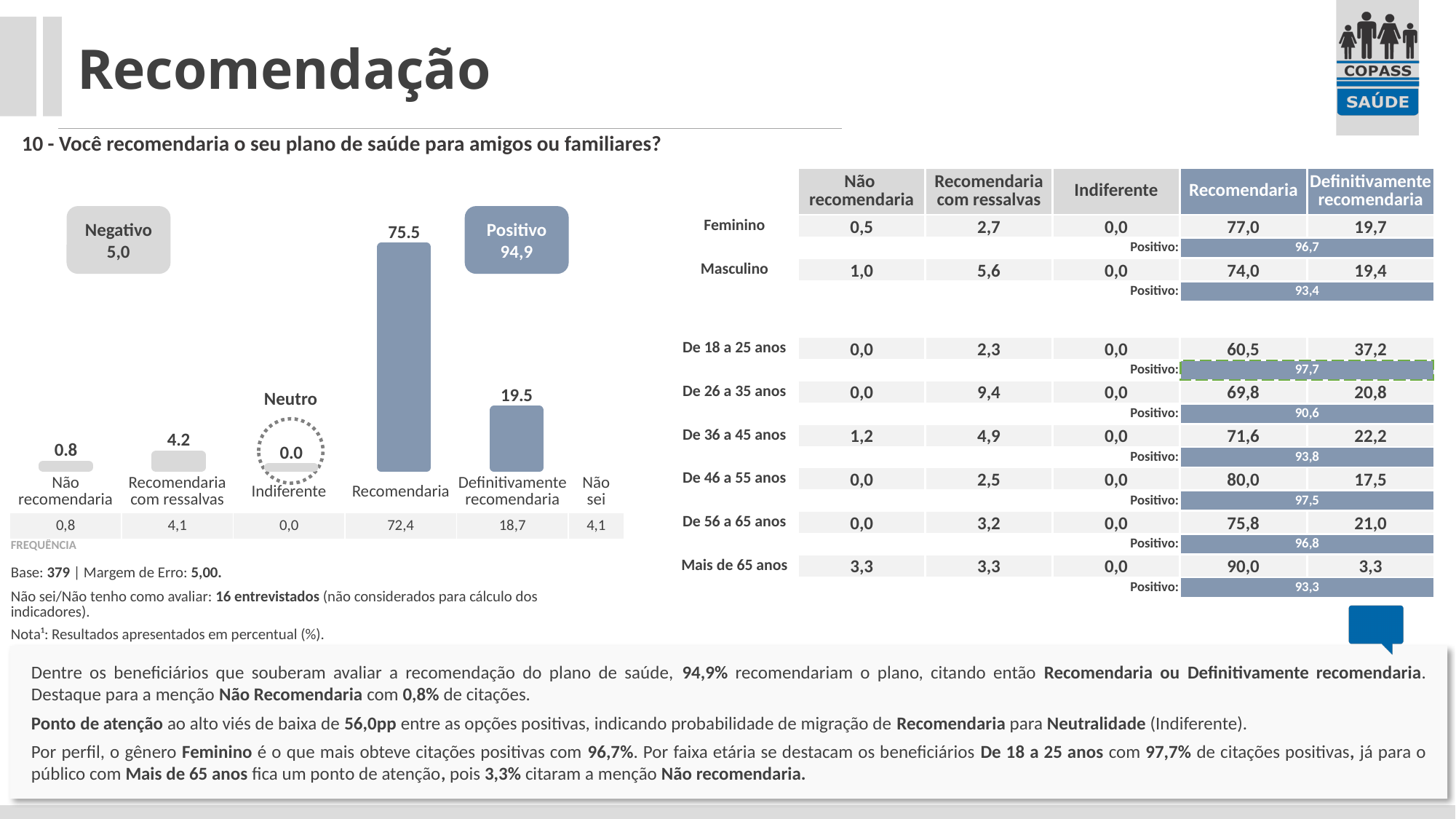
In the FREQUÊNCIA row below the bar chart, what is the value for Recomendaria? 72,4 In the bar chart, which category has the highest value? Recomendaria What kind of chart is shown on the left of the slide? Bar chart In the bar chart, what is the difference between the values for Recomendaria and Definitivamente recomendaria? 56.0 In the bar chart, which is larger: the value for Recomendaria com ressalvas or the value for Não recomendaria? Recomendaria com ressalvas In the bar chart, what value is shown in the Negativo box? 5,0 In the bar chart, what value is shown in the Positivo box? 94,9 In the bar chart, which category has the lowest value? Indiferente In the bar chart, what is the value for Recomendaria? 75.5 In the bar chart, what is the value for Recomendaria com ressalvas? 4.2 In the bar chart, what is the value for Não recomendaria? 0.8 In the bar chart, what is the value for Definitivamente recomendaria? 19.5